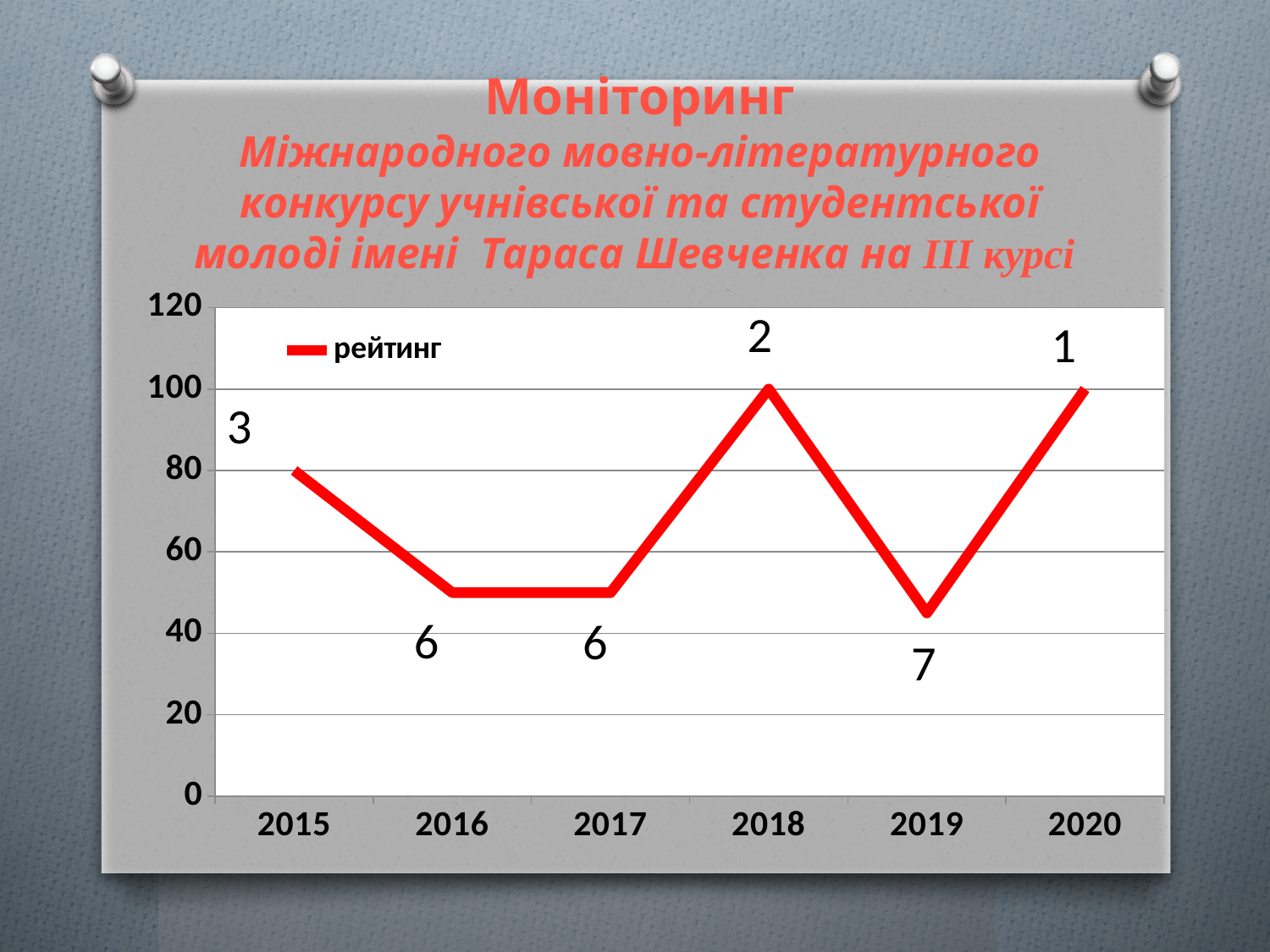
Is the plotted line for 2016 greater or less than 60 on the y axis? less What number is labelled next to the 2020 point on the chart? 1 Does the line rise or fall from 2015 to 2016? fall What number is labelled next to the 2019 point on the chart? 7 What number is labelled next to the 2015 point on the chart? 3 What is the name of the series shown in the chart legend? рейтинг Does the line rise or fall from 2019 to 2020? rise What number is labelled next to the 2018 point on the chart? 2 What colour is the line in the chart? red What kind of chart is shown on the slide? line chart How many years are plotted along the x axis of the chart? 6 How many series does the chart legend list? 1